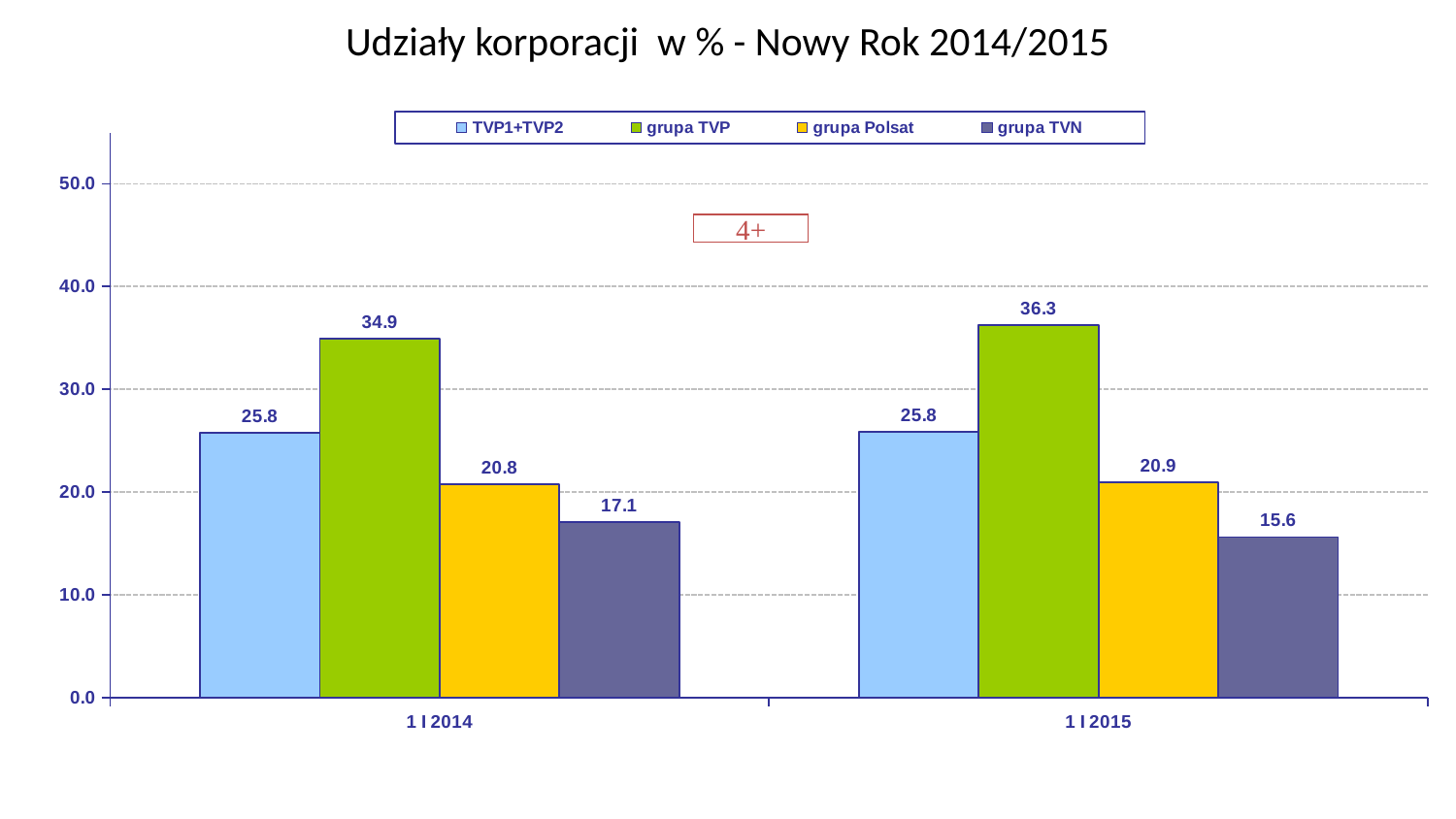
Which series has the highest value in 1 I 2015? grupa TVP What is the value for grupa TVN in 1 I 2015? 15.6 What kind of chart is shown on the slide? bar chart Is the value for grupa TVP in 1 I 2015 greater or less than 30.0? greater Which series has the lowest value in 1 I 2014? grupa TVN How many series does the legend list? 4 What is the title of the chart? Udziały korporacji w % - Nowy Rok 2014/2015 What is the difference between grupa TVP in 1 I 2015 and grupa TVP in 1 I 2014? 1.4 Which is larger: grupa Polsat in 1 I 2014 or grupa TVN in 1 I 2014? grupa Polsat in 1 I 2014 What is the difference between grupa TVN in 1 I 2014 and grupa TVN in 1 I 2015? 1.5 What is the value for grupa Polsat in 1 I 2015? 20.9 What is the value for grupa TVP in 1 I 2014? 34.9